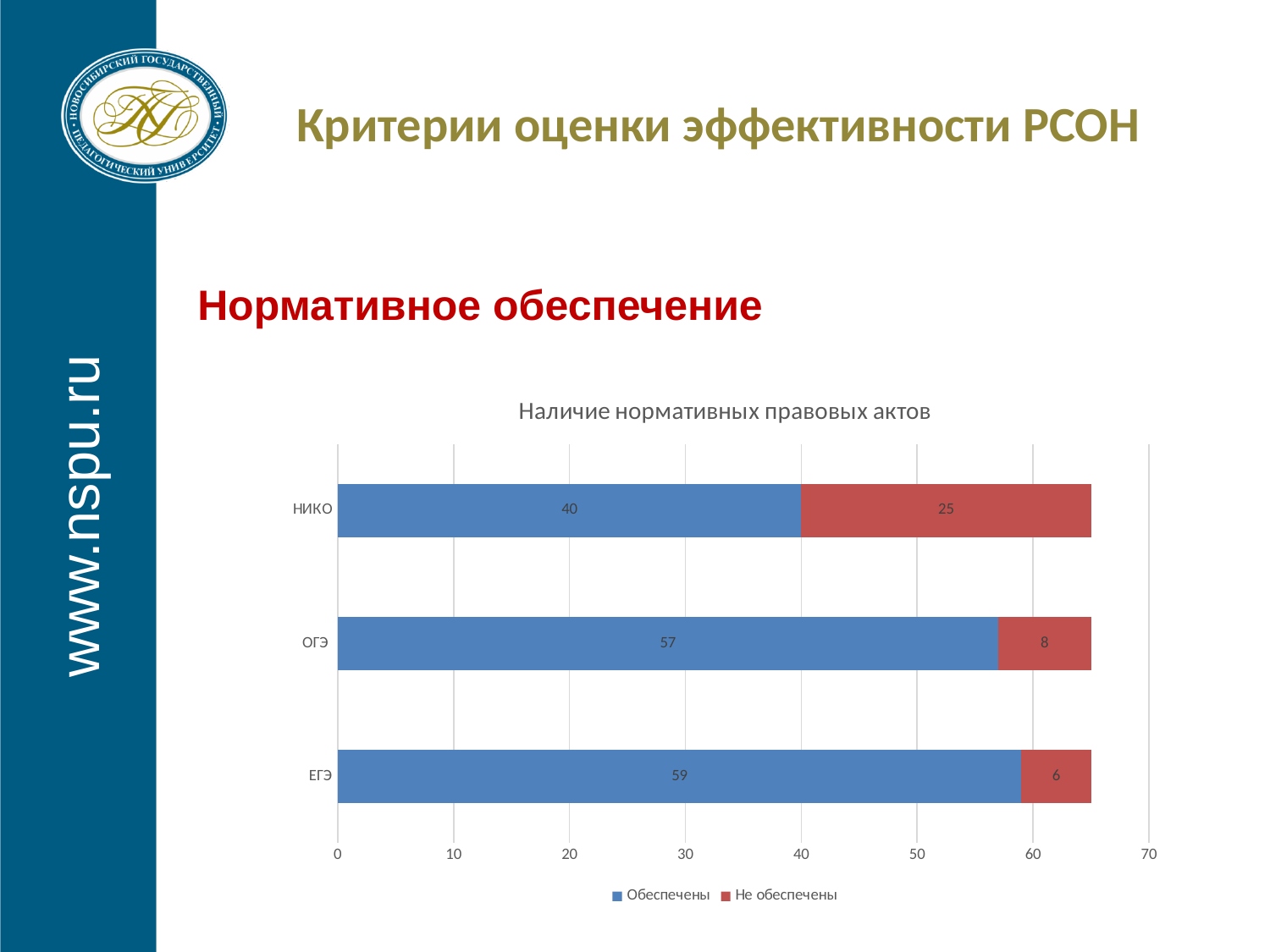
What is the value of "Не обеспечены" for ОГЭ? 8 What is the difference between the "Обеспечены" values for ОГЭ and НИКО? 17 What is the value of "Обеспечены" for ЕГЭ? 59 What kind of chart is shown on the slide? Stacked bar chart What is the total of the stacked bar for НИКО? 65 How many series does the legend list? 2 How many categories are shown on the chart? 3 Which category has the highest "Обеспечены" value? ЕГЭ Which category has the lowest "Не обеспечены" value? ЕГЭ Which is larger: the "Не обеспечены" value for НИКО or for ОГЭ? НИКО What is the value of "Обеспечены" for НИКО? 40 What is the title of the chart? Наличие нормативных правовых актов